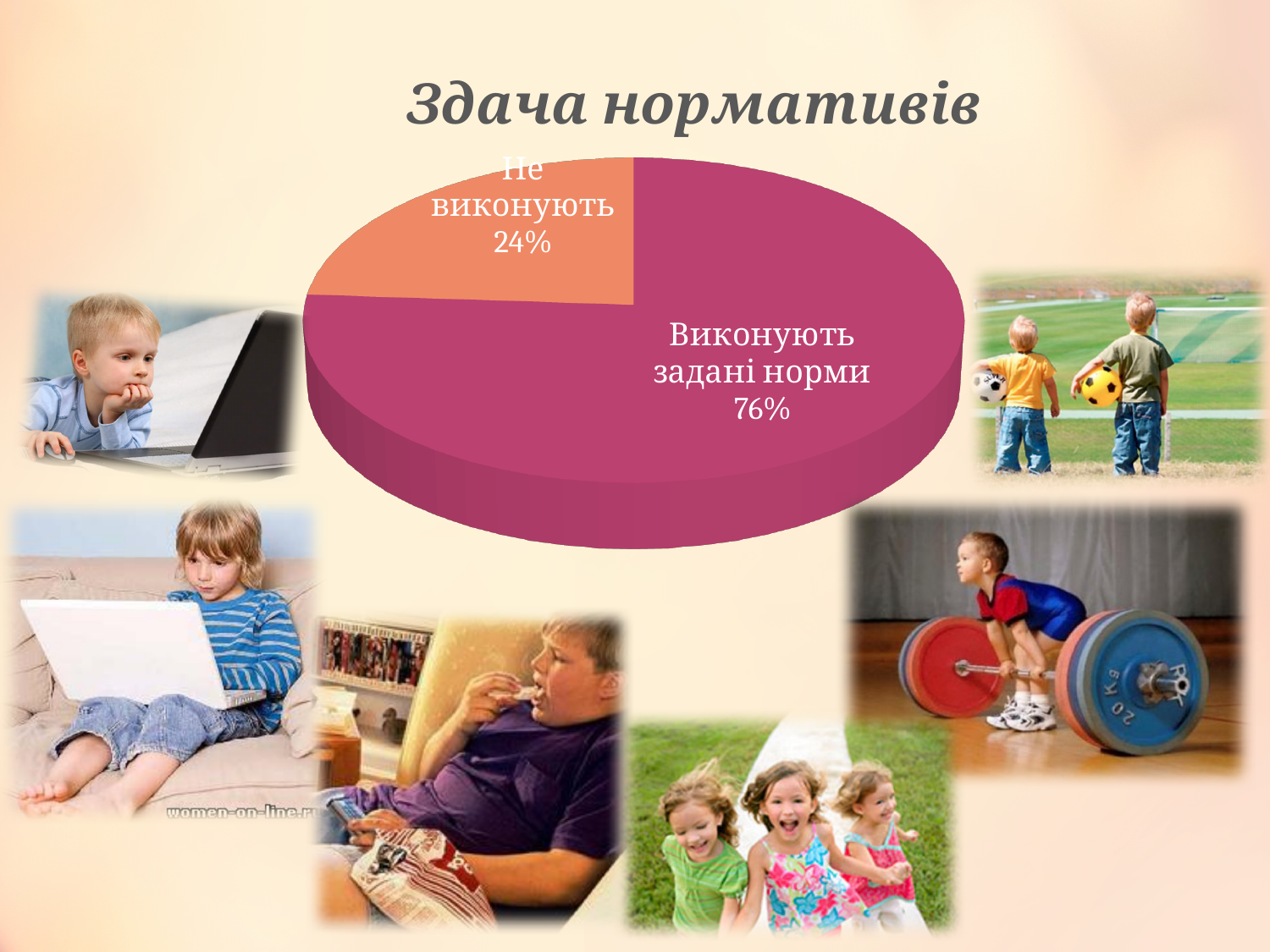
What is the difference in percentage points between the "Виконують задані норми" slice and the "Не виконують" slice? 52 Is the share for "Не виконують" greater or less than 50%? less How many slices does the pie chart have? 2 Which slice of the pie is the largest? Виконують задані норми What is the title of the chart? Здача нормативів Which slice of the pie is the smallest? Не виконують What share of the pie is labelled "Виконують задані норми"? 76% What share of the pie is labelled "Не виконують"? 24% Which is larger: the "Не виконують" slice or the "Виконують задані норми" slice? Виконують задані норми What colour is the "Не виконують" slice? orange What type of chart is shown on the slide? pie chart